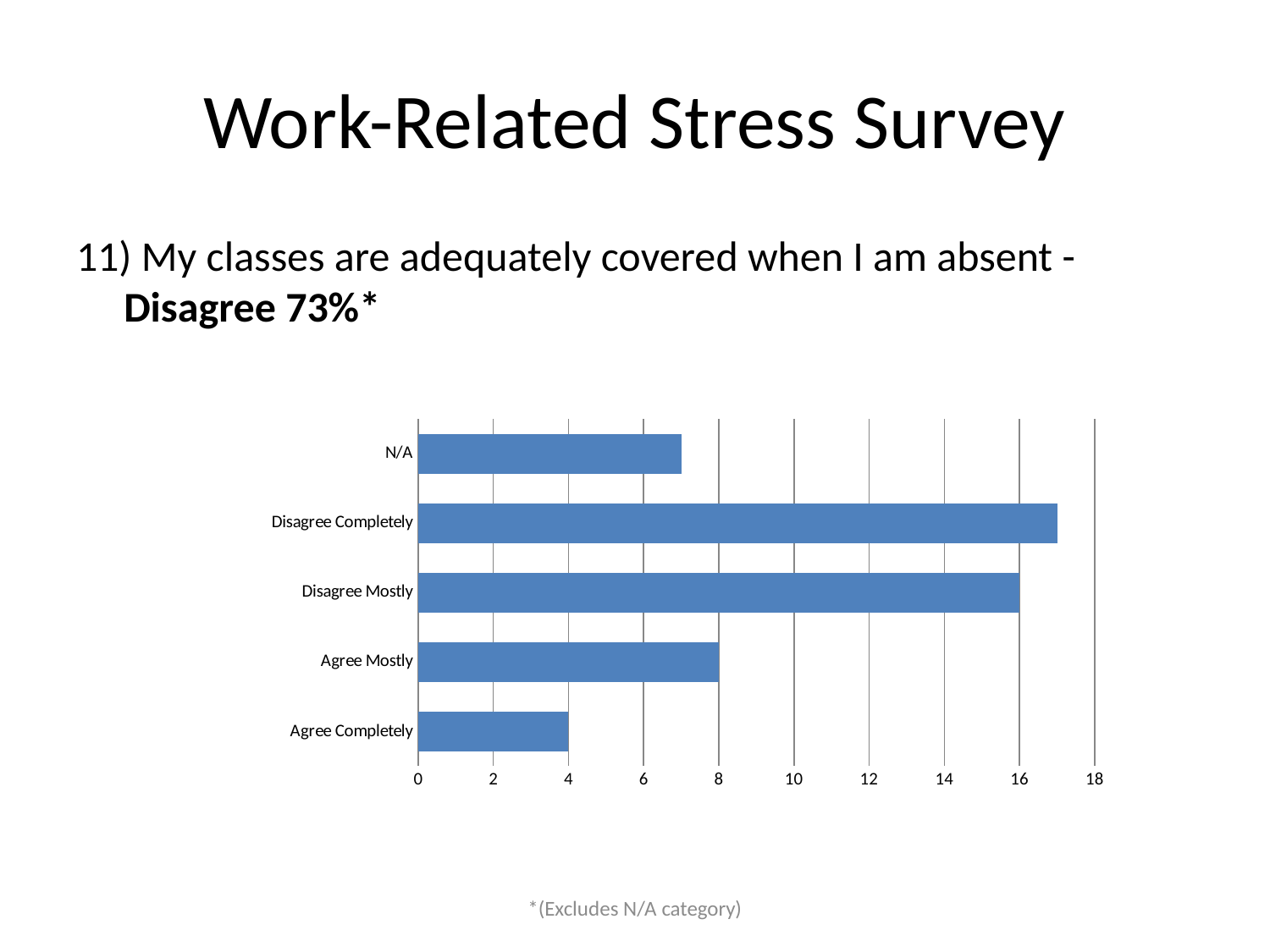
What kind of chart is shown on the slide? bar chart What is the difference between the values for Agree Mostly and Agree Completely? 4 What is the difference between the values for Disagree Mostly and Agree Mostly? 8 Is the value for N/A greater or less than 6? greater Which category has the highest value? Disagree Completely Is the value for Disagree Completely greater or less than 16? greater Which category has the lowest value? Agree Completely What is the value for Disagree Mostly? 16 What is the value for Agree Completely? 4 How many categories are shown in the chart? 5 What is the value for Agree Mostly? 8 Which is larger, the value for Agree Mostly or the value for N/A? Agree Mostly